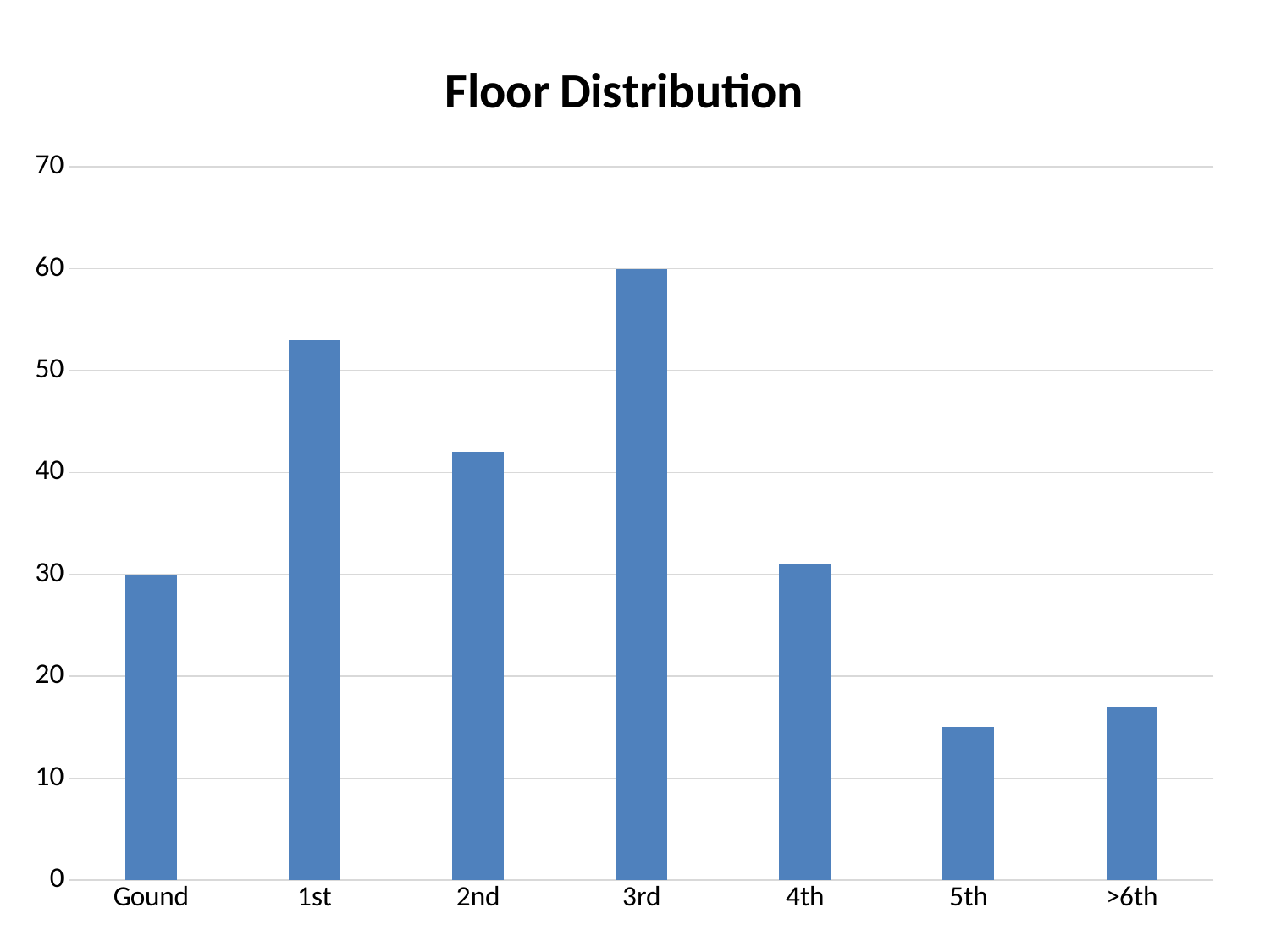
Is the value for the 1st floor greater or less than 50? greater Which is larger, the value for the 1st floor or the value for the 2nd floor? 1st Is the value for the 5th floor greater or less than 20? less Which floor has the lowest value? 5th Do the values rise or fall from the 3rd floor to the 5th floor? fall Which floor has the highest value? 3rd What is the value for Gound? 30 What type of chart is shown on the slide? Bar chart What is the title of the chart? Floor Distribution How many floor categories are shown on the x axis? 7 What is the value for the 3rd floor? 60 What is the difference between the value for the 3rd floor and the value for Gound? 30